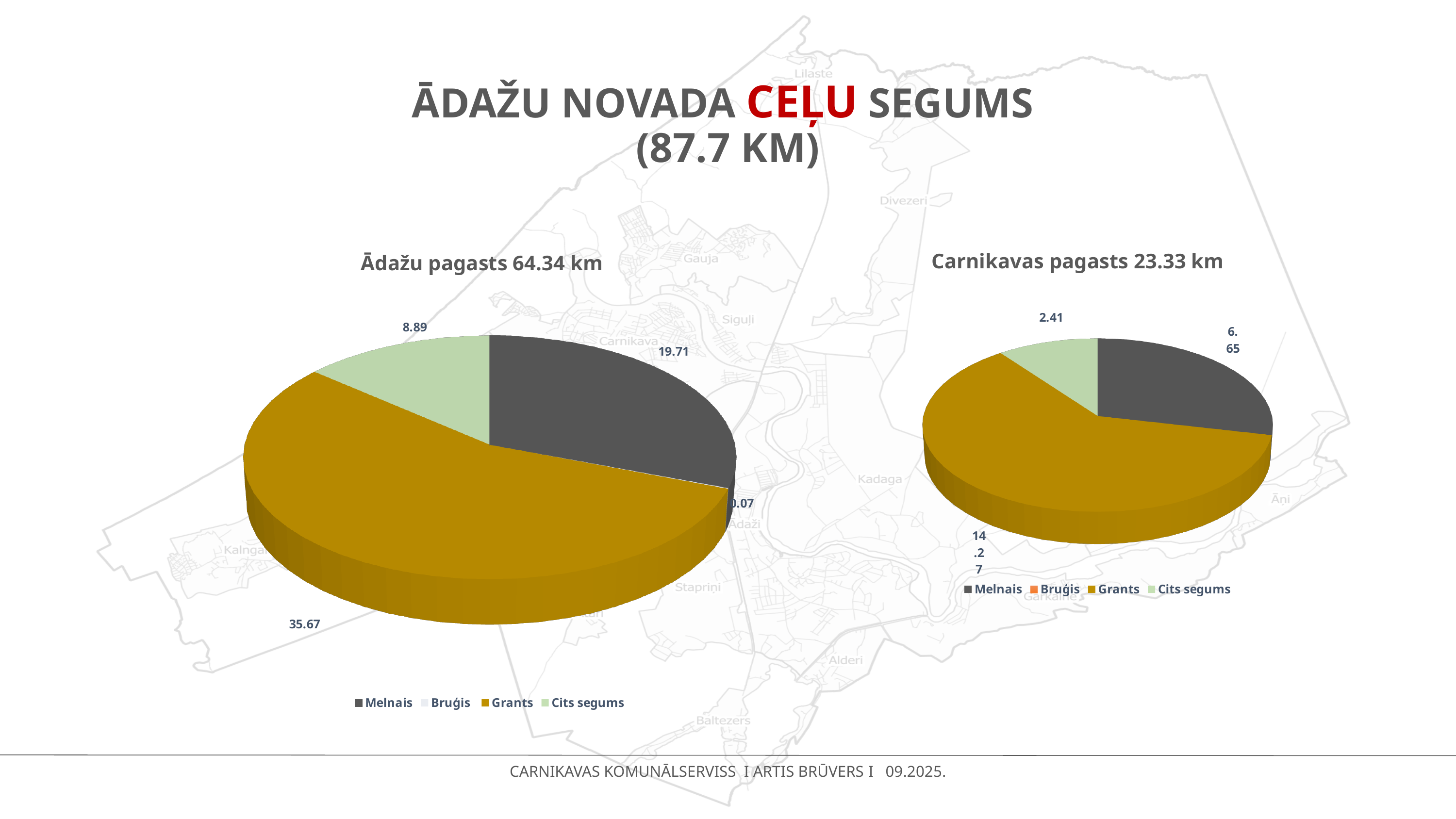
In the Ādažu pagasts 64.34 km chart, what is the value for Grants? 35.67 What type of chart is used for Ādažu pagasts 64.34 km? Pie chart In the Ādažu pagasts 64.34 km chart, what is the value for Cits segums? 8.89 In the Ādažu pagasts 64.34 km chart, what is the difference between Grants and Melnais? 15.96 How many entries does the legend of the Carnikavas pagasts 23.33 km chart list? 4 In the Carnikavas pagasts 23.33 km chart, which is larger, Melnais or Cits segums? Melnais In the Carnikavas pagasts 23.33 km chart, what is the value for Melnais? 6.65 In the Ādažu pagasts 64.34 km chart, what is the value for Melnais? 19.71 In the Carnikavas pagasts 23.33 km chart, what is the value for Cits segums? 2.41 In the Ādažu pagasts 64.34 km chart, which category has the largest slice? Grants In the Carnikavas pagasts 23.33 km chart, what is the difference between Grants and Melnais? 7.62 In the Carnikavas pagasts 23.33 km chart, what is the value for Grants? 14.27